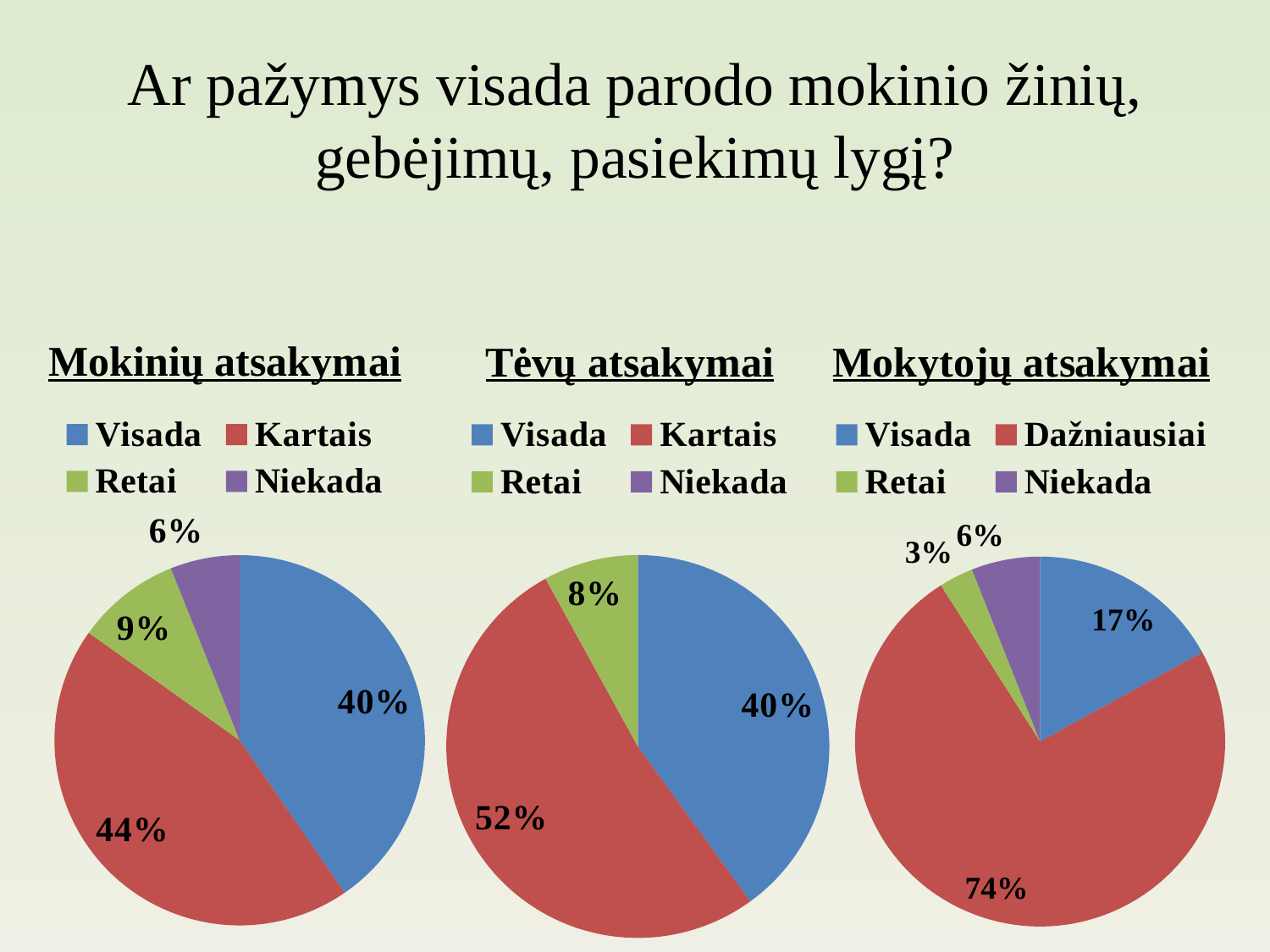
In the 'Tėvų atsakymai' chart, what percentage is shown for Retai? 8% In the 'Mokinių atsakymai' chart, what percentage is shown for Niekada? 6% How many entries does the legend of the 'Mokytojų atsakymai' chart list? 4 In the 'Tėvų atsakymai' chart, what is the difference between the Kartais and Visada shares? 12% In the 'Mokytojų atsakymai' chart, which category has the largest share? Dažniausiai In the 'Mokytojų atsakymai' chart, what is the difference between the Dažniausiai and Visada shares? 57% In the 'Mokinių atsakymai' chart, which is larger: Visada or Kartais? Kartais In the 'Mokinių atsakymai' chart, which category has the smallest share? Niekada In the 'Mokytojų atsakymai' chart, which legend entry replaces 'Kartais' used in the other two charts? Dažniausiai In the 'Mokinių atsakymai' chart, what percentage is shown for Kartais? 44% In the 'Mokytojų atsakymai' chart, what percentage is shown for Visada? 17% What type of chart is used for 'Tėvų atsakymai'? Pie chart